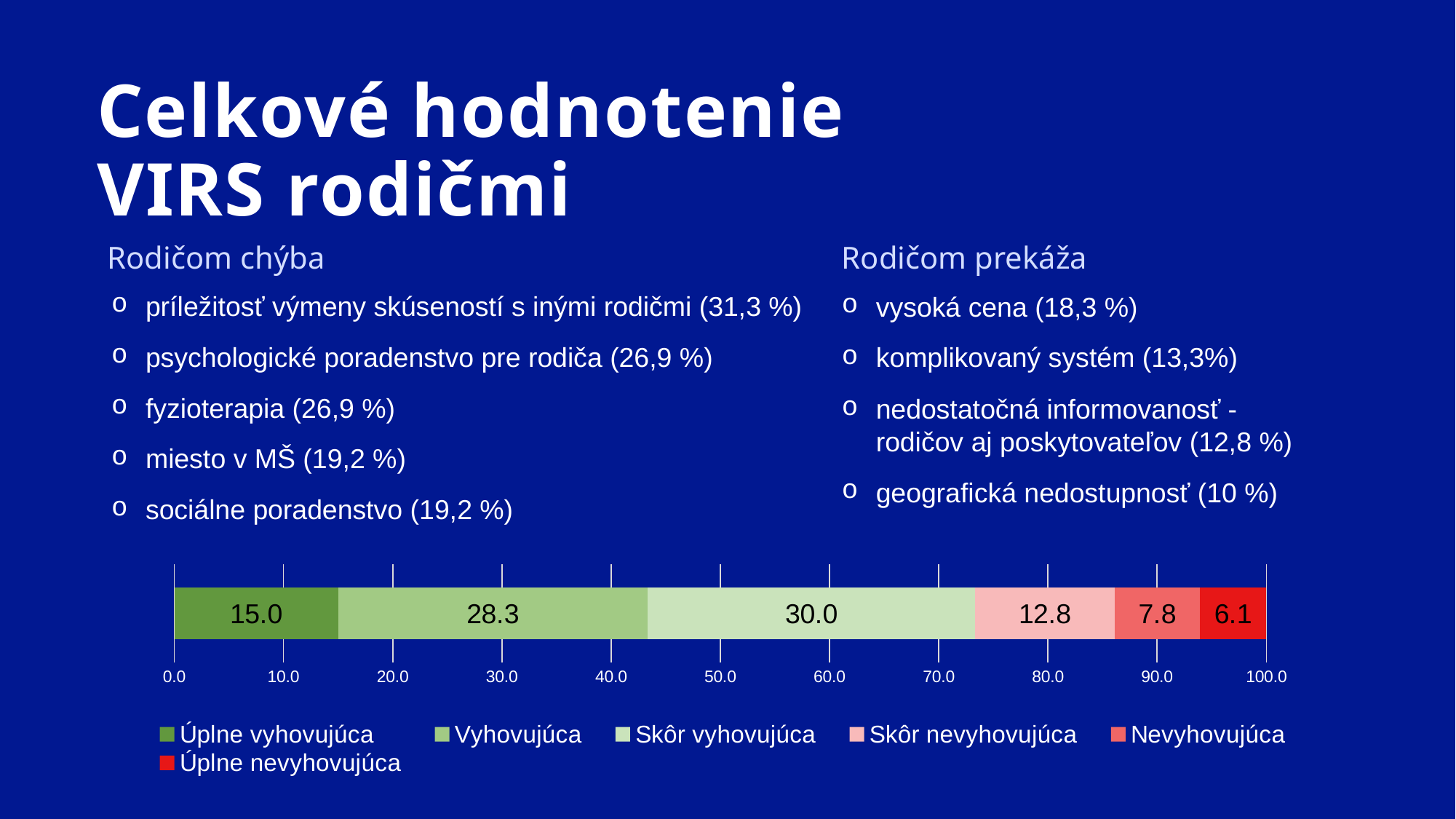
What is the value of the Úplne nevyhovujúca segment in the stacked bar? 6.1 Which is larger, the Vyhovujúca segment or the Skôr nevyhovujúca segment? Vyhovujúca How many series does the chart legend list? 6 Which segment of the stacked bar has the smallest value? Úplne nevyhovujúca What is the value of the Skôr nevyhovujúca segment in the stacked bar? 12.8 What colour is the Úplne nevyhovujúca segment in the chart? Red What is the combined value of the three green segments (Úplne vyhovujúca, Vyhovujúca, Skôr vyhovujúca)? 73.3 What kind of chart is shown on the slide? Stacked bar chart Which segment of the stacked bar has the largest value? Skôr vyhovujúca What is the total of all segments in the stacked bar? 100.0 What is the difference between the Vyhovujúca and Nevyhovujúca segment values? 20.5 What is the value of the Úplne vyhovujúca segment in the stacked bar? 15.0